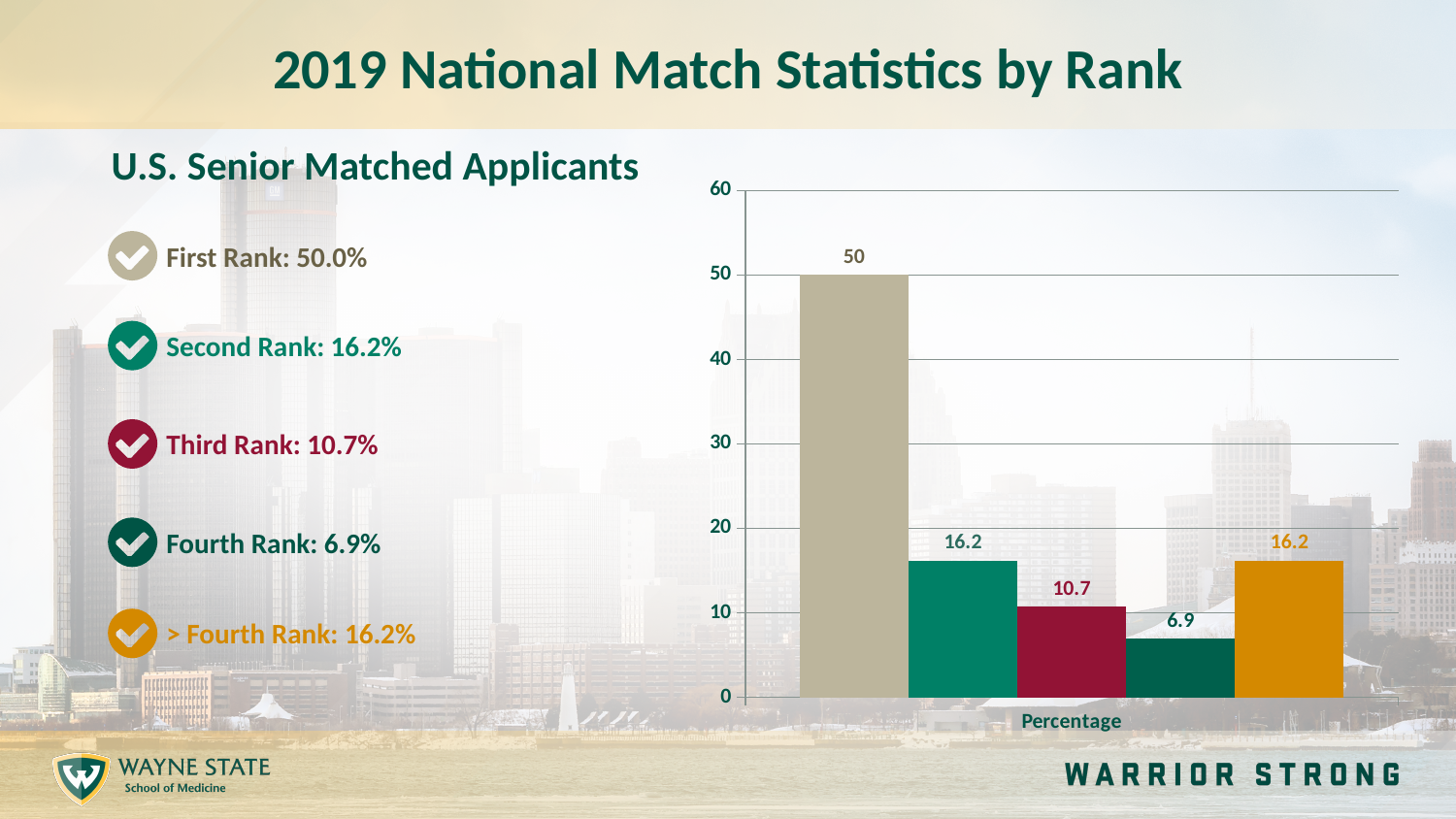
What value is labelled on the dark green bar in the chart? 6.9 What kind of chart is shown on the slide? bar chart What is the label on the x axis of the chart? Percentage Is the value of the tan bar greater or less than 40? greater What value is labelled on the maroon bar in the chart? 10.7 What is the difference between the tan bar (50) and the teal bar (16.2) in the chart? 33.8 How many bars are plotted in the chart? 5 What value is labelled on the orange bar in the chart? 16.2 Which bar in the chart has the lowest value? the dark green bar (6.9) What is the difference between the maroon bar (10.7) and the dark green bar (6.9) in the chart? 3.8 Which is larger in the chart, the maroon bar or the orange bar? the orange bar What value is labelled on the tallest (tan) bar in the chart? 50